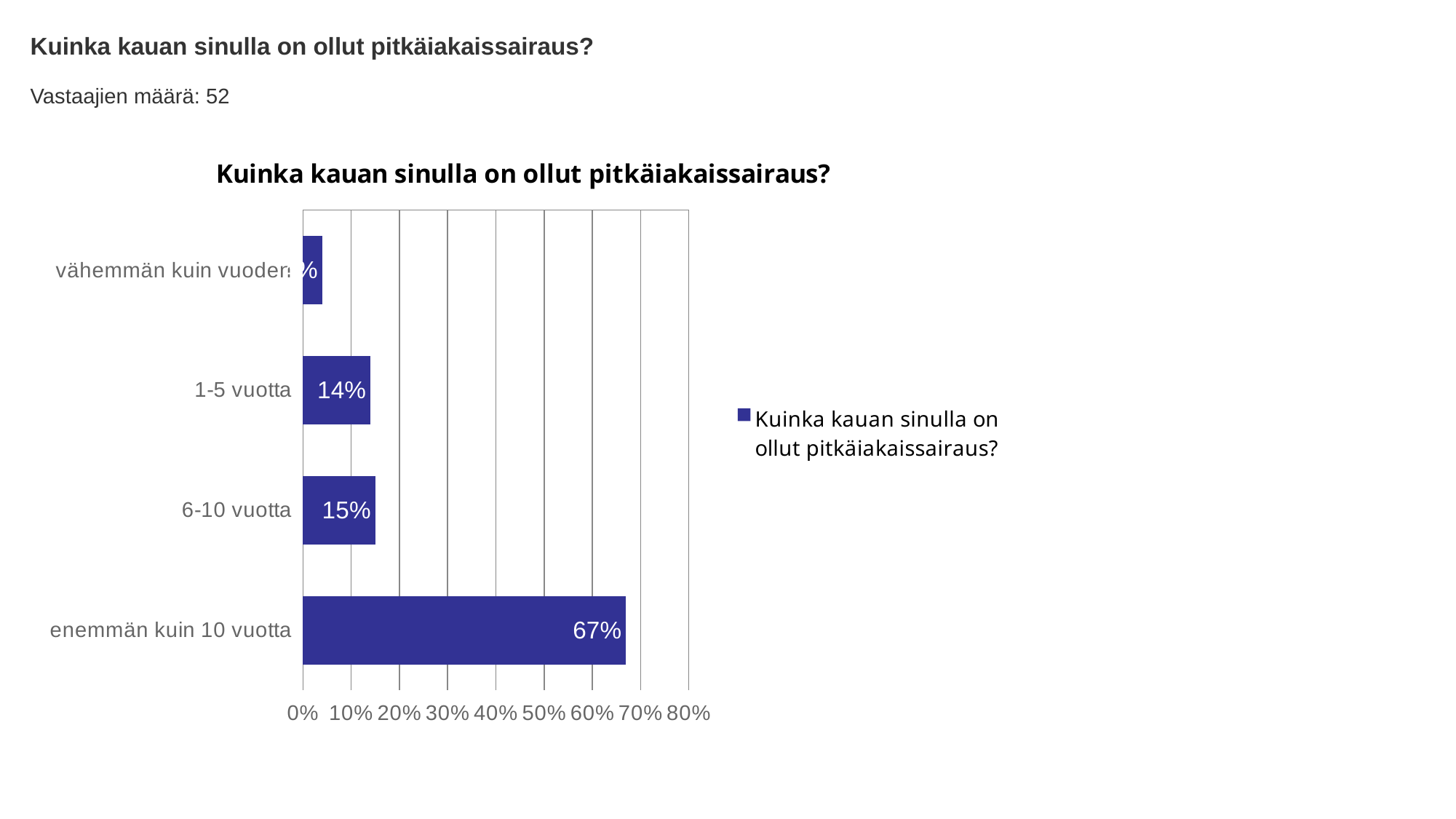
Which category has the highest percentage? enemmän kuin 10 vuotta What percentage is shown for the category "enemmän kuin 10 vuotta"? 67% How many categories are shown in the chart? 4 Is the value for the topmost bar (vähemmän kuin vuoden) greater or less than 10%? less What kind of chart is shown on the slide? bar chart How many series does the legend list? 1 Which has the larger value, "1-5 vuotta" or "6-10 vuotta"? 6-10 vuotta What percentage is shown for the category "1-5 vuotta"? 14% What percentage is shown for the category "6-10 vuotta"? 15% What is the difference in percentage points between "6-10 vuotta" and "1-5 vuotta"? 1 percentage point What is the difference in percentage points between "enemmän kuin 10 vuotta" and "1-5 vuotta"? 53 percentage points Is the value for "enemmän kuin 10 vuotta" greater or less than 60%? greater